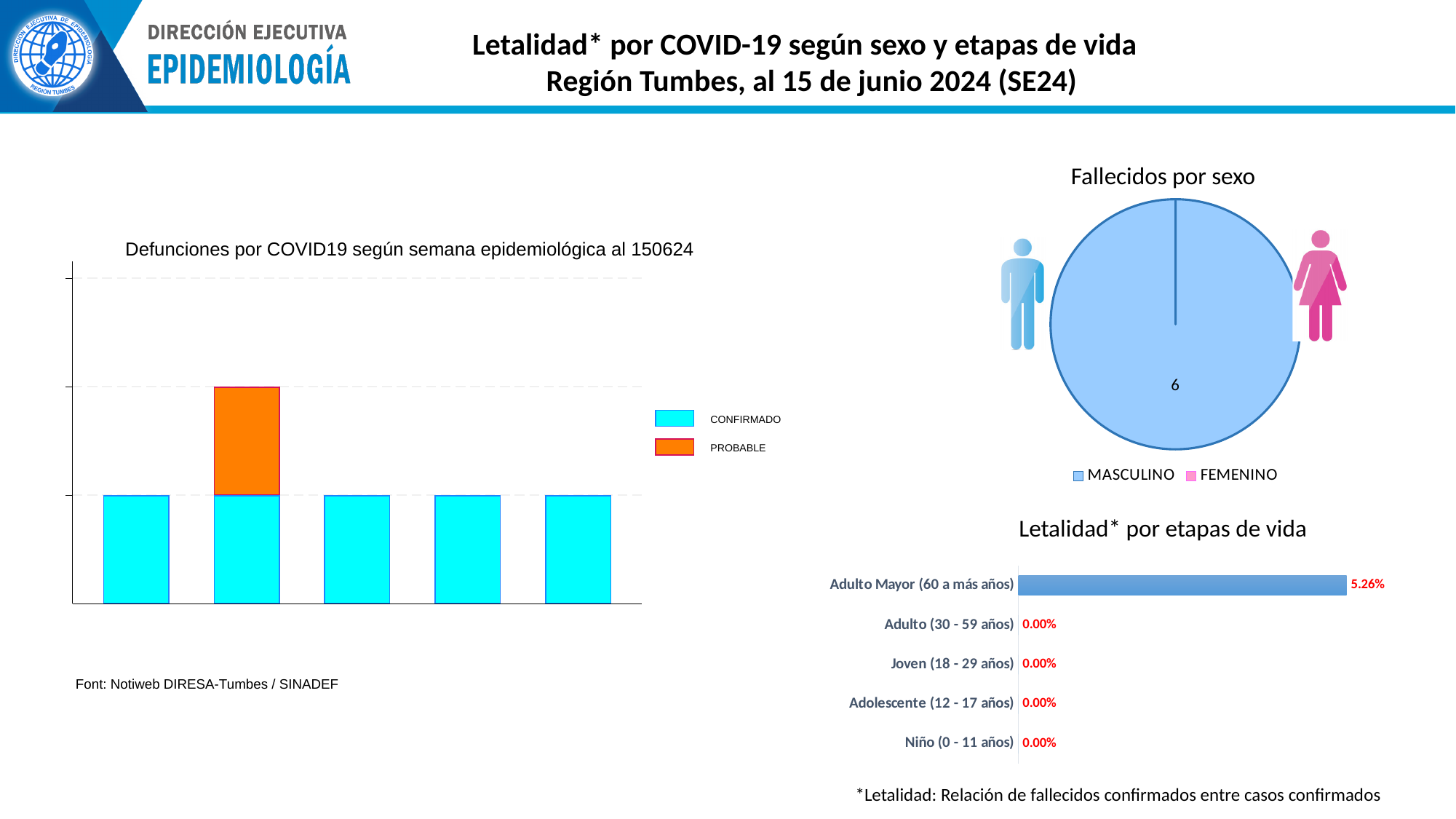
In the chart 'Fallecidos por sexo', what value is printed on the pie? 6 In the chart 'Letalidad* por etapas de vida', what is the value for Adulto Mayor (60 a más años)? 5.26% How many entries does the legend of the chart 'Fallecidos por sexo' list? 2 What kind of chart is 'Letalidad* por etapas de vida'? Bar chart In the chart 'Letalidad* por etapas de vida', which age group has the highest value? Adulto Mayor (60 a más años) How many series does the legend of the chart 'Defunciones por COVID19 según semana epidemiológica al 150624' list? 2 In the chart 'Letalidad* por etapas de vida', what is the value for Adulto (30 - 59 años)? 0.00% What kind of chart is 'Fallecidos por sexo'? Pie chart How many bars are shown in the chart 'Defunciones por COVID19 según semana epidemiológica al 150624'? 5 In the chart 'Letalidad* por etapas de vida', what is the difference between the values for Adulto Mayor (60 a más años) and Niño (0 - 11 años)? 5.26% In the chart 'Defunciones por COVID19 según semana epidemiológica al 150624', which series is shown in orange? PROBABLE In the chart 'Letalidad* por etapas de vida', how many age groups are shown? 5